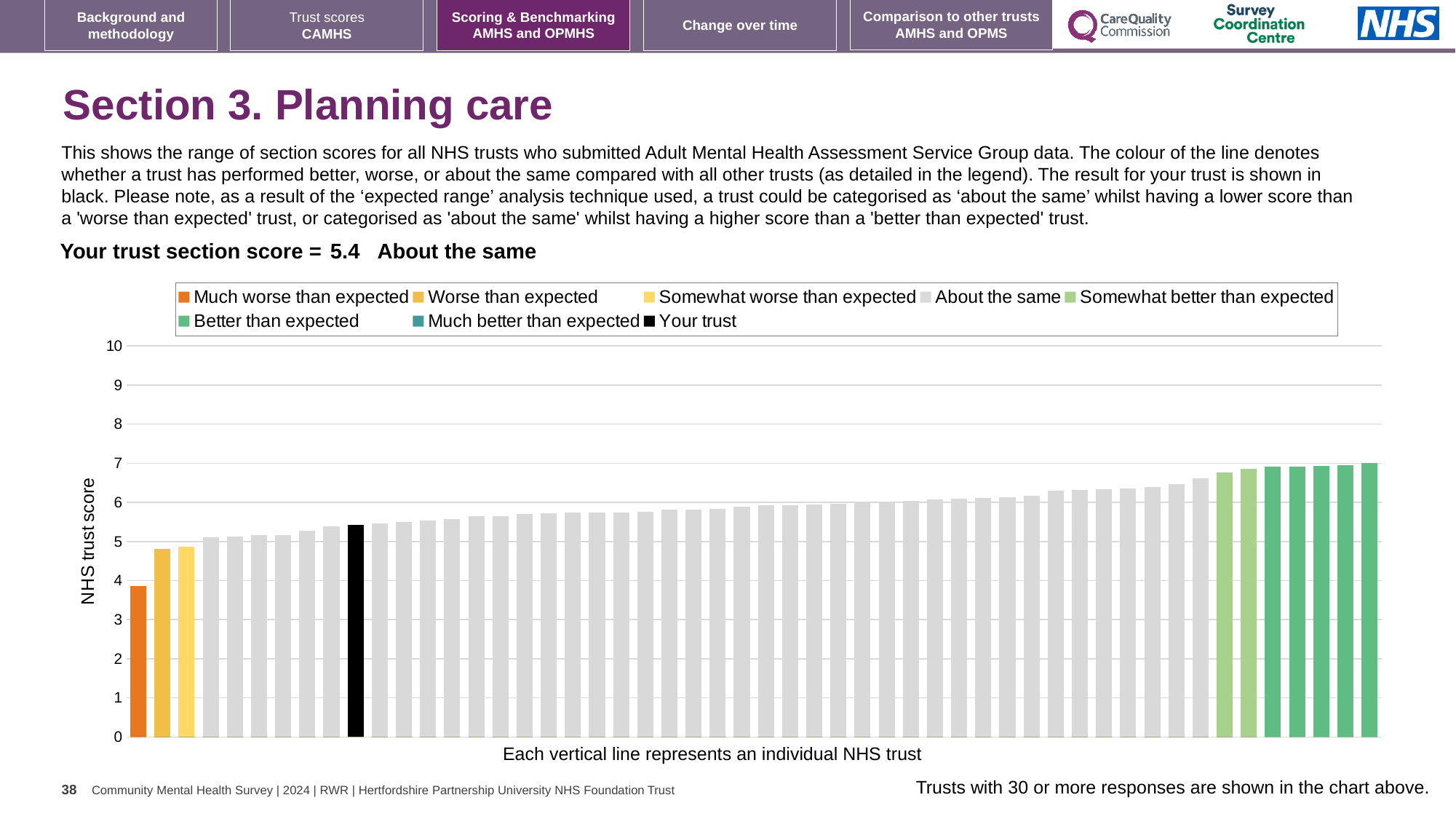
What kind of chart is shown on the slide? bar chart Is the value of the lowest bar (the orange bar) greater or less than 5? less Which is larger: the value for your trust (black bar) or the value of the orange bar? your trust (black bar) Is the value of the tallest bar greater or less than 6? greater What is the label on the y axis of the chart? NHS trust score Which category is your trust placed in for this section? About the same Which legend category does the tallest bar belong to? Better than expected Is the value for your trust (the black bar) greater or less than 5? greater How many entries does the chart legend list? 8 Which legend category does the lowest bar belong to? Much worse than expected What is the section score for your trust? 5.4 Do the bar values rise or fall from left to right along the x axis? rise